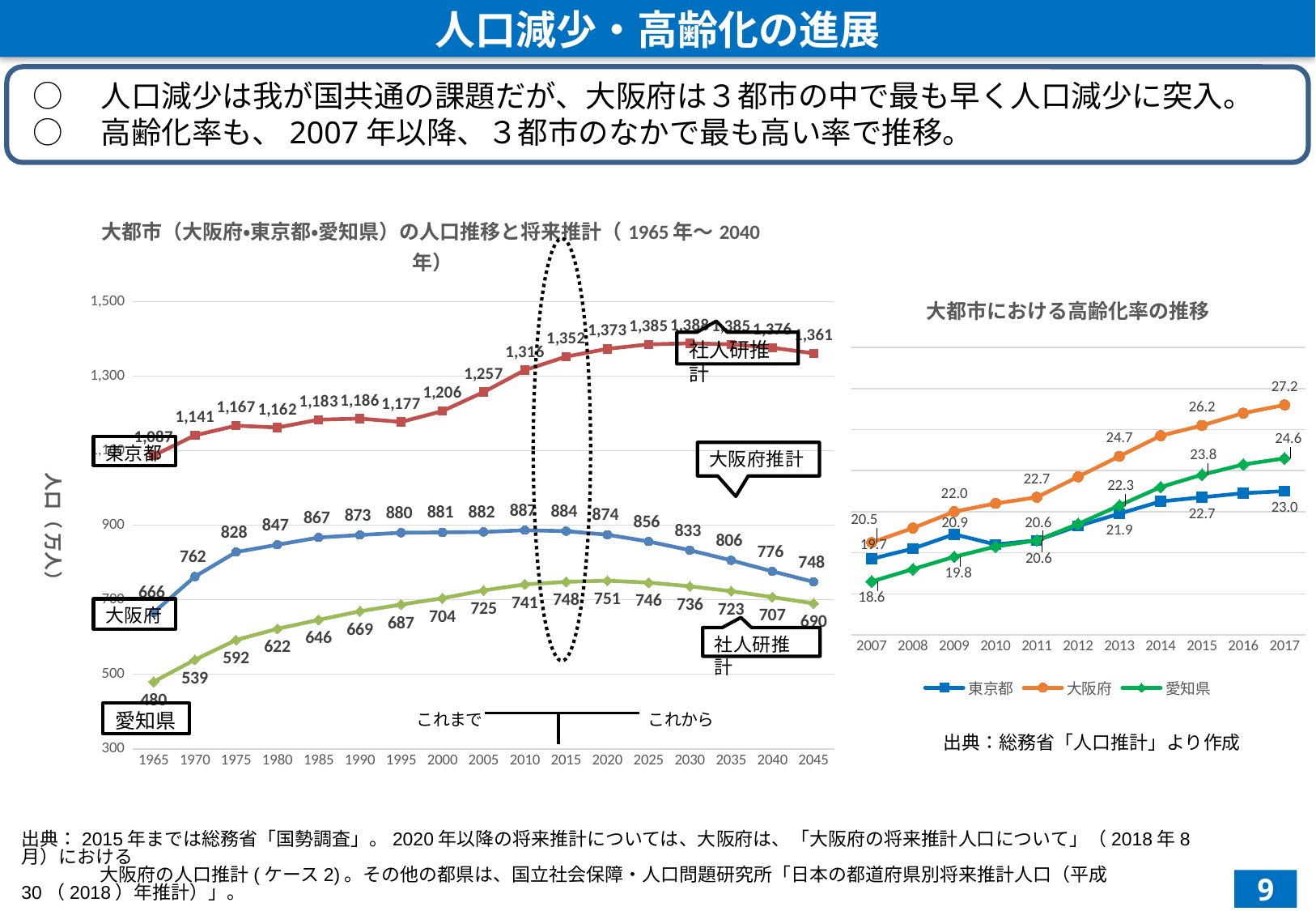
In the left chart (大都市の人口推移と将来推計), which is larger in 2020: 大阪府 or 愛知県? 大阪府 In the left chart (大都市の人口推移と将来推計), what is the value for 愛知県 in 2045? 690 In the right chart (大都市における高齢化率の推移), how many series does the legend list? 3 In the left chart (大都市の人口推移と将来推計), what is the value for 大阪府 in 2010? 887 In the left chart (大都市の人口推移と将来推計), in which year does 大阪府 reach its highest value? 2010 In the right chart (大都市における高齢化率の推移), which prefecture has the highest value in 2017? 大阪府 In the left chart (大都市の人口推移と将来推計), what is the value for 東京都 in 2030? 1,388 In the left chart (大都市の人口推移と将来推計), what is the difference between 大阪府 and 愛知県 in 2045? 58 In the right chart (大都市における高齢化率の推移), what is the value for 大阪府 in 2017? 27.2 In the left chart (大都市の人口推移と将来推計), does the 大阪府 line rise or fall from 2015 to 2045? fall What kind of chart is the right chart (大都市における高齢化率の推移)? line chart In the right chart (大都市における高齢化率の推移), what is the difference between 大阪府 and 東京都 in 2015? 3.5